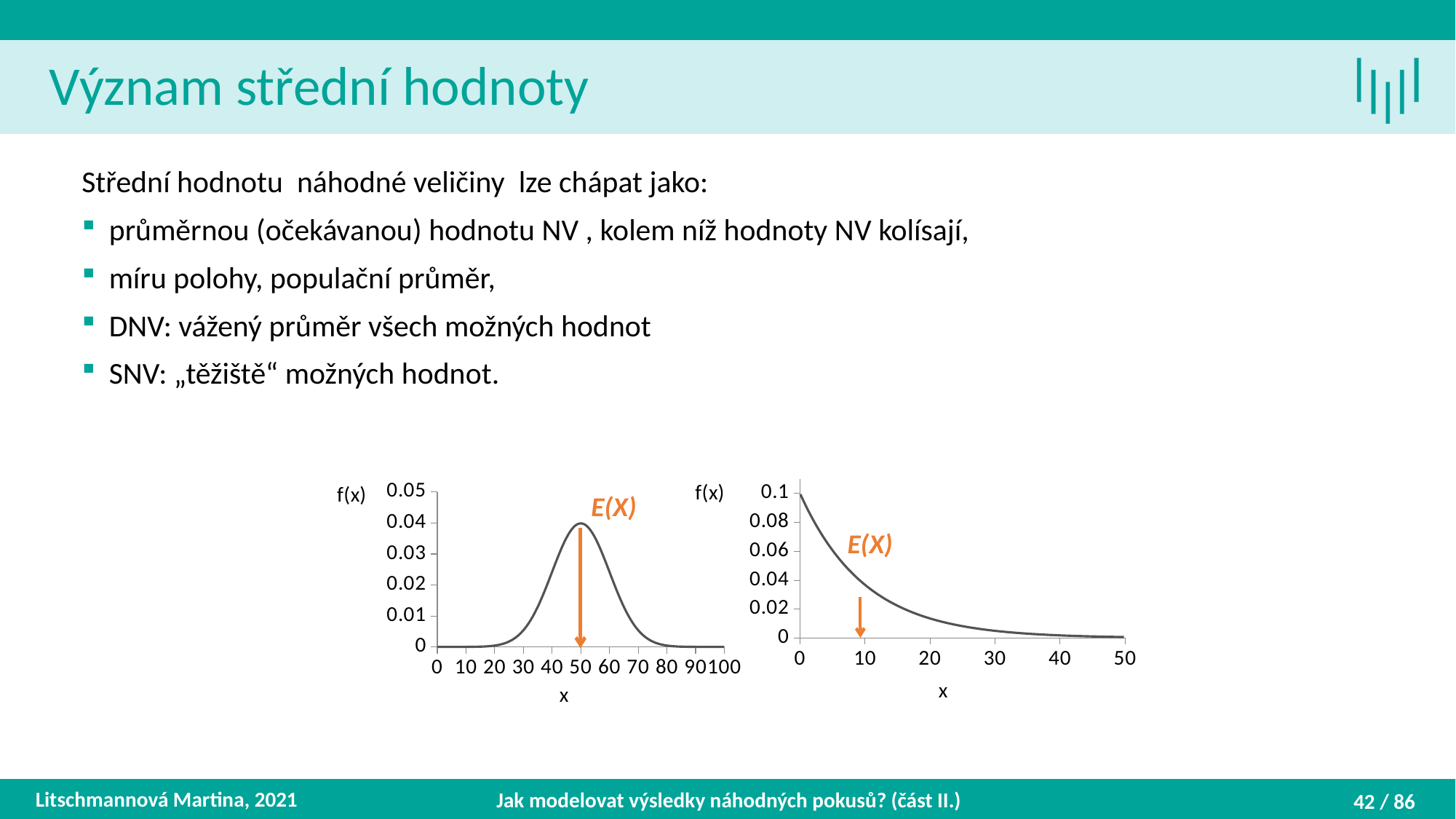
In the left chart (x axis 0 to 100), which has the larger f(x) value: x = 50 or x = 20? x = 50 In the right chart (x axis 0 to 50), is the value of f(x) at x = 0 greater or less than 0.08? greater In the right chart (x axis 0 to 50), is the value of f(x) at x = 30 greater or less than 0.02? less What kind of chart is the left chart (x axis 0 to 100)? line chart In the right chart (x axis 0 to 50), do the values rise or fall as x increases? fall In the left chart (x axis 0 to 100), is the value of f(x) at x = 50 greater or less than 0.03? greater In the right chart (x axis 0 to 50), at which x value does the orange E(X) arrow point? 10 In the left chart (x axis 0 to 100), at which x value does the curve reach its highest point? 50 What is the highest tick value shown on the vertical axis of the right chart (x axis 0 to 50)? 0.1 In the right chart (x axis 0 to 50), which has the larger f(x) value: x = 10 or x = 40? x = 10 What kind of chart is the right chart (x axis 0 to 50)? line chart